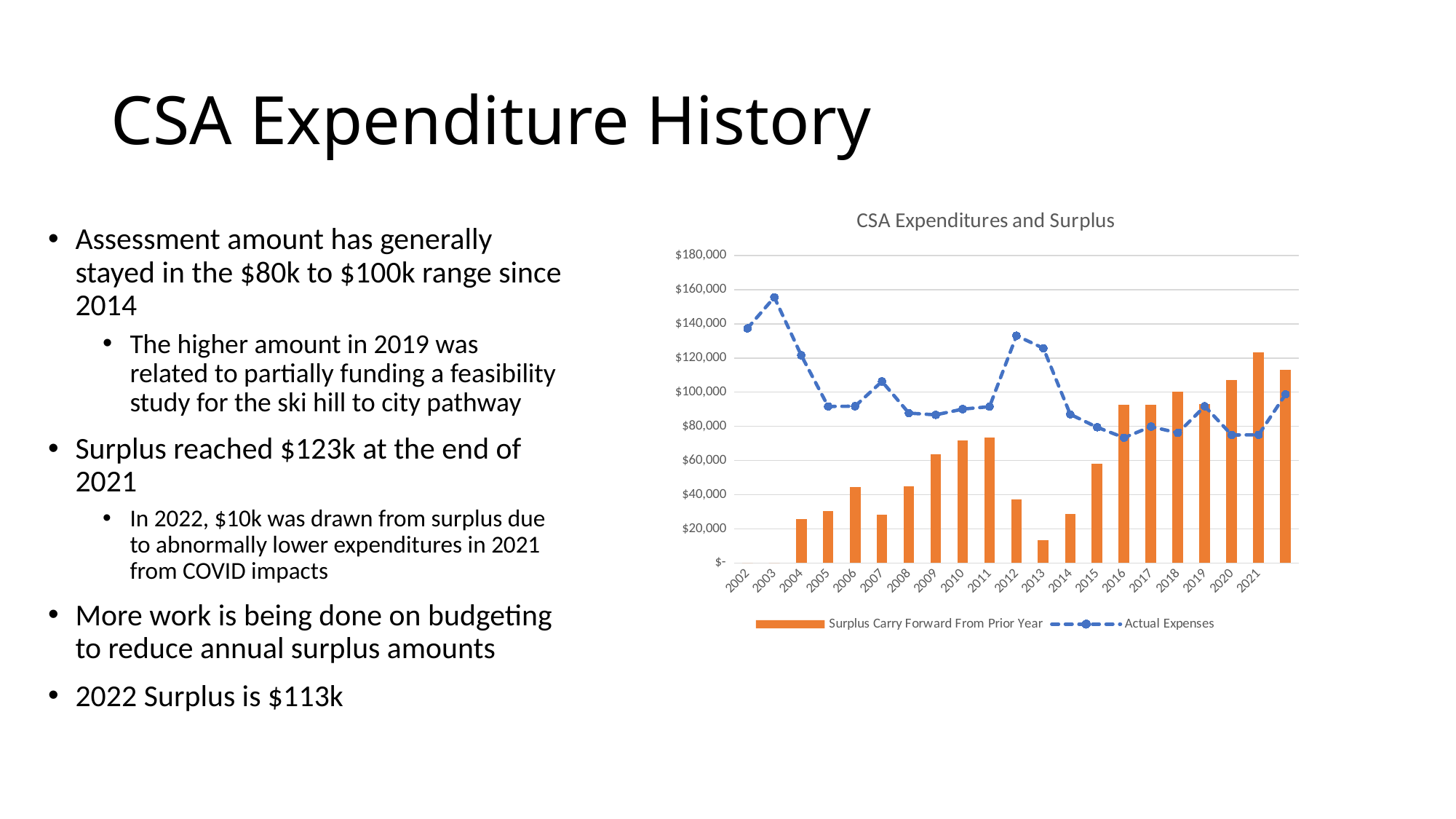
What kind of chart is shown on the slide? Combined bar and line chart What is the title of the chart on the slide? CSA Expenditures and Surplus In which year is the Actual Expenses value highest? 2003 Which year has the larger Surplus Carry Forward From Prior Year bar, 2009 or 2012? 2009 Which series is drawn as a dashed line in the chart? Actual Expenses Which year has the higher Actual Expenses value, 2007 or 2008? 2007 How many series does the chart legend list? 2 Is the Surplus Carry Forward From Prior Year value for 2010 greater or less than $60,000? greater Is the Actual Expenses value for 2016 greater or less than $80,000? less Is the Actual Expenses value for 2003 greater or less than $140,000? greater In which labelled year is the Surplus Carry Forward From Prior Year bar lowest? 2013